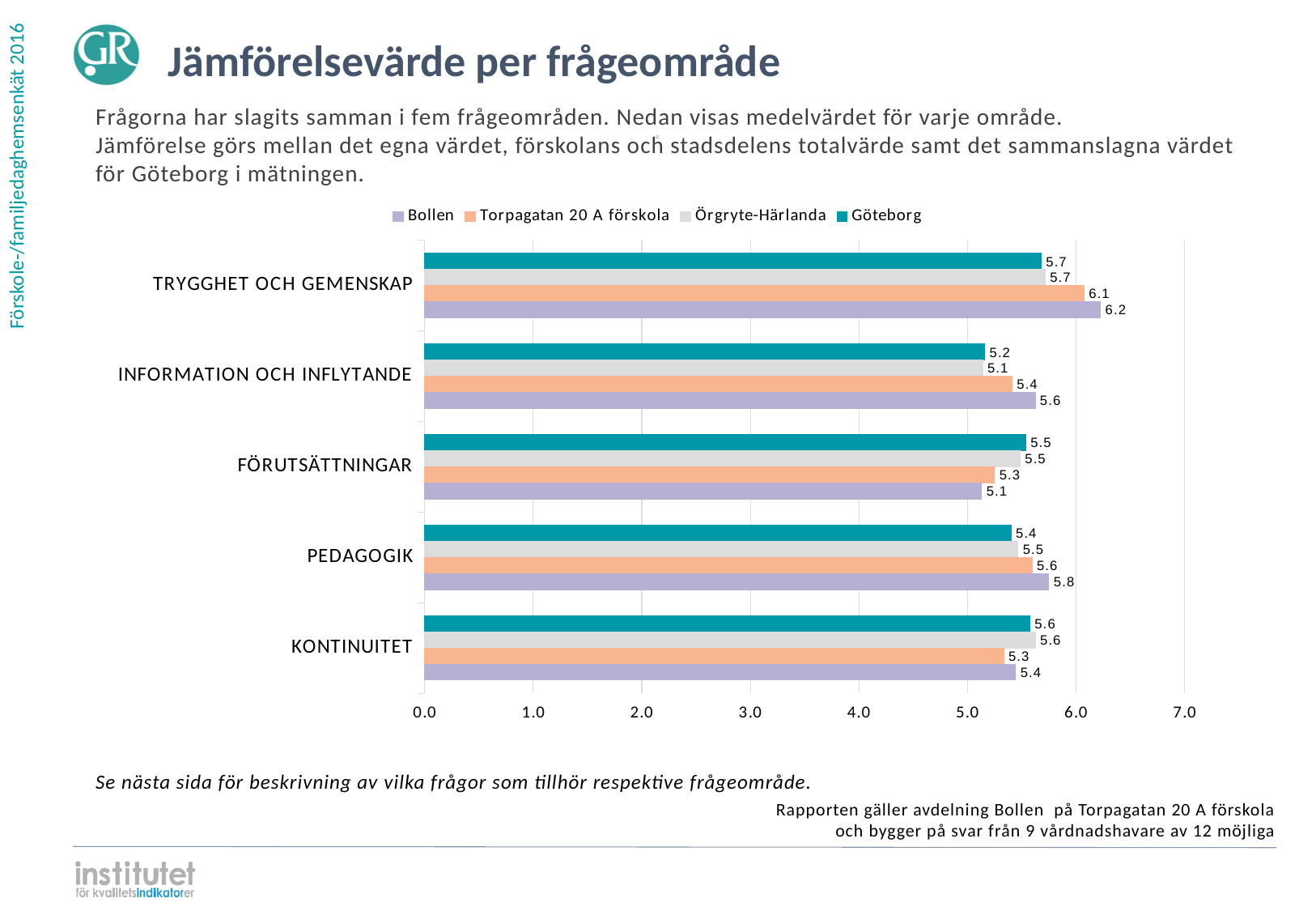
What is the value for Göteborg in the INFORMATION OCH INFLYTANDE category? 5.2 What is the value for Torpagatan 20 A förskola in the KONTINUITET category? 5.3 What kind of chart is shown on the slide? bar chart How many series does the legend list? 4 In which category does Bollen have its highest value? TRYGGHET OCH GEMENSKAP Is the value for Bollen in the PEDAGOGIK category greater or less than 5.0? greater What is the difference between the Bollen value and the Göteborg value in the TRYGGHET OCH GEMENSKAP category? 0.5 In which category does Bollen have its lowest value? FÖRUTSÄTTNINGAR In the FÖRUTSÄTTNINGAR category, which is larger: the value for Bollen or the value for Göteborg? Göteborg What is the value for Örgryte-Härlanda in the PEDAGOGIK category? 5.5 How many categories are shown on the chart? 5 What is the value for Bollen in the TRYGGHET OCH GEMENSKAP category? 6.2